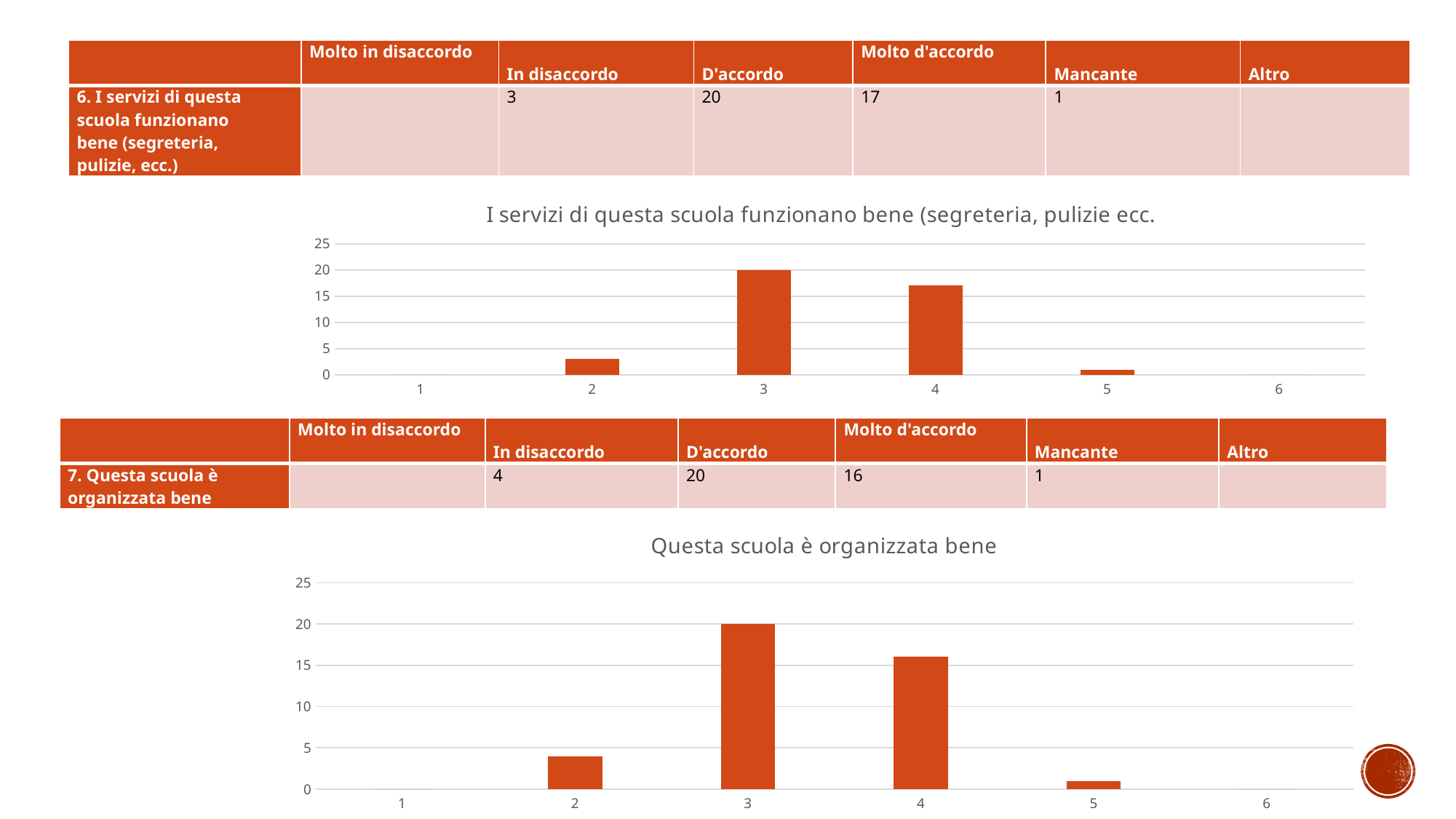
In the chart titled "I servizi di questa scuola funzionano bene (segreteria, pulizie ecc.", what is the value for category 3? 20 What is the highest value shown on the y axis of the chart titled "I servizi di questa scuola funzionano bene (segreteria, pulizie ecc."? 25 In the chart titled "Questa scuola è organizzata bene", what is the difference between the values for category 3 and category 4? 4 How many categories are shown on the x axis of the chart titled "Questa scuola è organizzata bene"? 6 In the chart titled "Questa scuola è organizzata bene", what is the value for category 4? 16 In the chart titled "Questa scuola è organizzata bene", is the value for category 2 greater or less than 5? less In the chart titled "I servizi di questa scuola funzionano bene (segreteria, pulizie ecc.", which category has the highest bar? 3 What kind of chart is the chart titled "I servizi di questa scuola funzionano bene (segreteria, pulizie ecc."? bar chart In the chart titled "I servizi di questa scuola funzionano bene (segreteria, pulizie ecc.", is the value for category 4 greater or less than 15? greater In the chart titled "I servizi di questa scuola funzionano bene (segreteria, pulizie ecc.", which is larger, the bar for category 2 or the bar for category 4? 4 In the chart titled "Questa scuola è organizzata bene", which is larger, the bar for category 3 or the bar for category 5? 3 In the chart titled "Questa scuola è organizzata bene", which category has the highest bar? 3